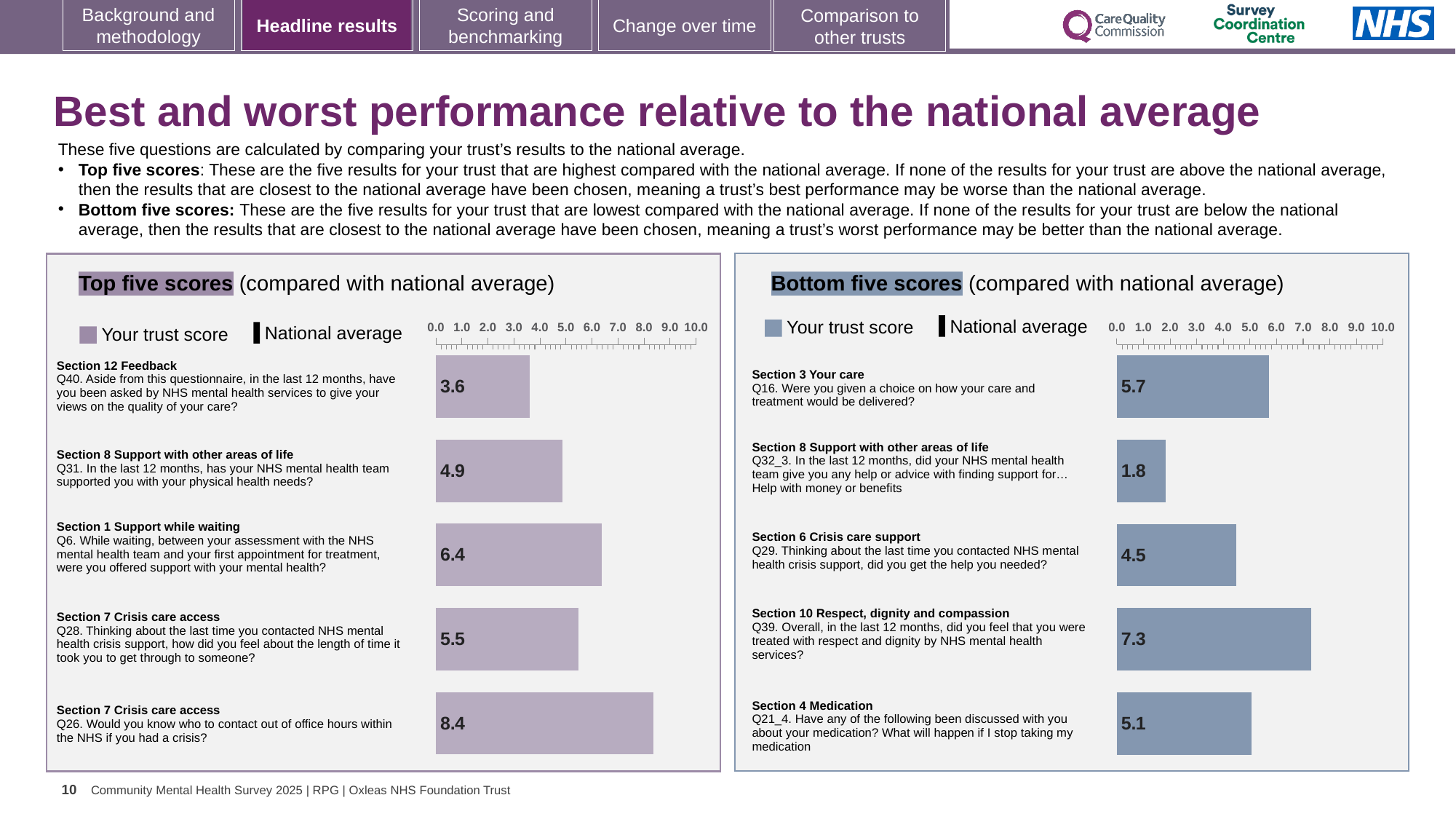
What type of chart is used for the Top five scores? Bar chart In the Top five scores chart, what is the difference between the trust scores for Q26 and Q40? 4.8 In the Top five scores chart, what is the trust score for Q26 (Would you know who to contact out of office hours within the NHS if you had a crisis?)? 8.4 In the Bottom five scores chart, which question has the lowest trust score? Q32_3 (help with money or benefits) In the Top five scores chart, is the trust score for Q6 greater or less than 5.0? greater In the Top five scores chart, what is the trust score for Q40 (Aside from this questionnaire, in the last 12 months, have you been asked by NHS mental health services to give your views on the quality of your care?)? 3.6 In the Bottom five scores chart, what is the difference between the trust scores for Q39 and Q32_3? 5.5 In the Bottom five scores chart, which has the larger trust score, Q16 or Q21_4? Q16 In the Top five scores chart, which question has the highest trust score? Q26 How many bars are shown in the Bottom five scores chart? 5 How many entries does the legend of the Bottom five scores chart list? 2 In the Bottom five scores chart, what is the trust score for Q39 (treated with respect and dignity by NHS mental health services)? 7.3